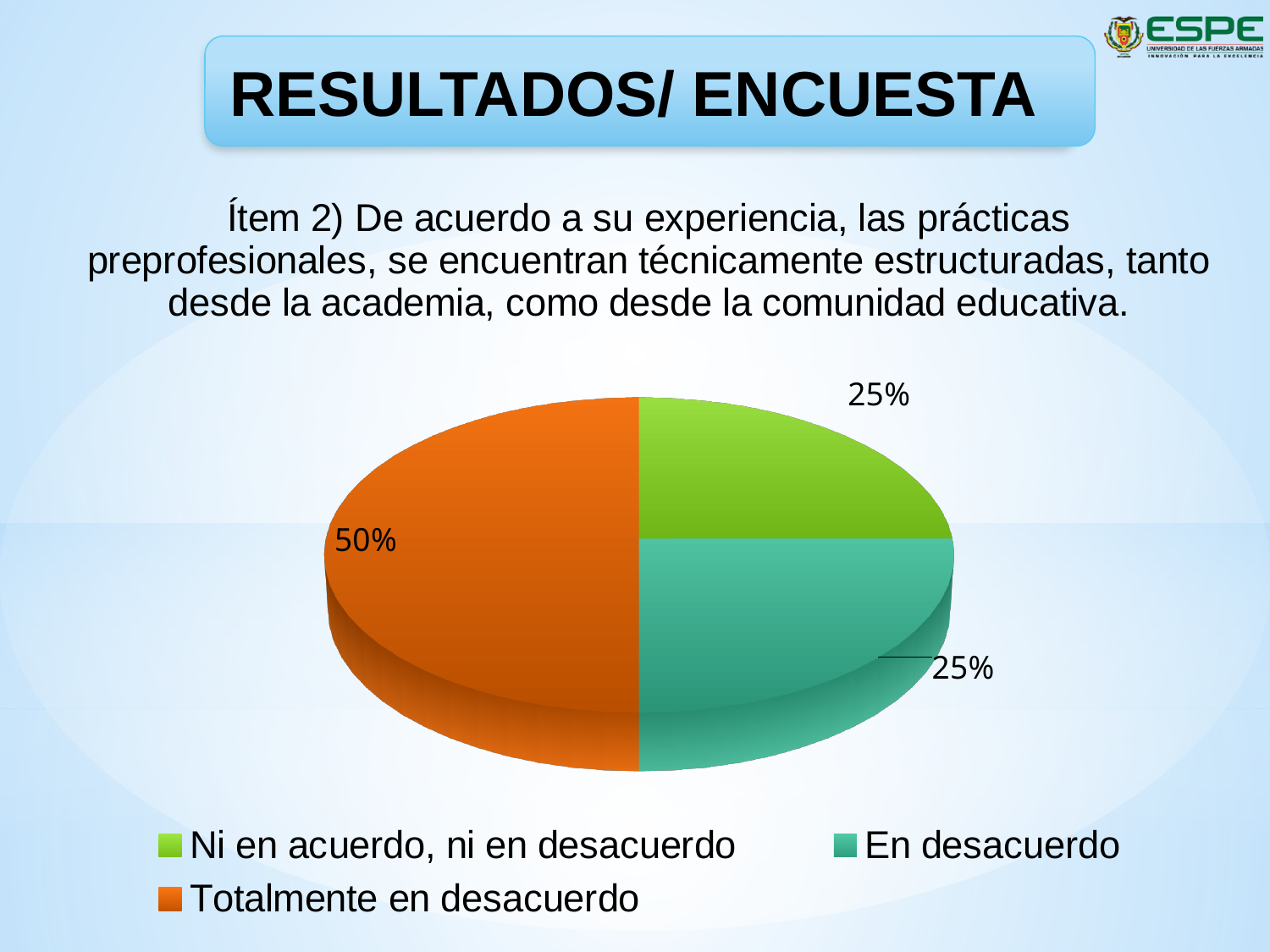
Which is larger: the share for "Totalmente en desacuerdo" or the share for "Ni en acuerdo, ni en desacuerdo"? Totalmente en desacuerdo How many entries does the legend list? 3 What share of the pie does "Totalmente en desacuerdo" have? 50% Which colour represents "Totalmente en desacuerdo" in the pie chart? orange What share of the pie does "Ni en acuerdo, ni en desacuerdo" have? 25% What is the combined share of "Ni en acuerdo, ni en desacuerdo" and "En desacuerdo"? 50% Which colour represents "En desacuerdo" in the pie chart? teal Which category has the largest slice of the pie? Totalmente en desacuerdo What share of the pie does "En desacuerdo" have? 25% What kind of chart is shown on the slide? pie chart What is the difference between the share for "Totalmente en desacuerdo" and the share for "En desacuerdo"? 25% How many categories does the pie chart show? 3